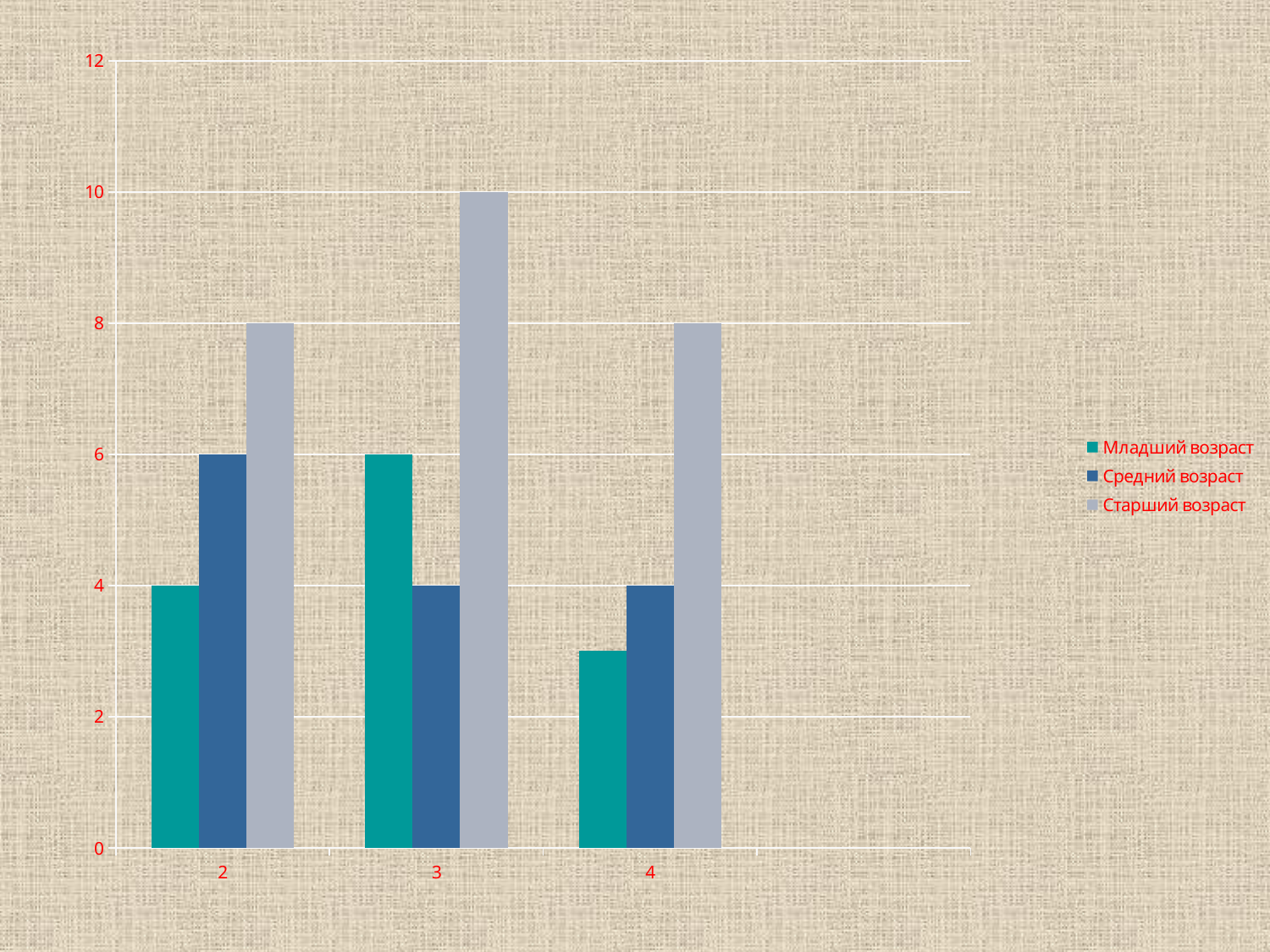
What is the difference between the Старший возраст values in category 3 and category 2? 2 How many categories are shown on the x axis? 3 What is the value for Старший возраст in category 3? 10 Is the value for Младший возраст in category 4 greater or less than 4? less How many series does the legend list? 3 Which series is shown in light gray in the legend? Старший возраст What is the value for Младший возраст in category 2? 4 In which category is the value for Старший возраст highest? 3 Does the value for Средний возраст rise or fall from category 2 to category 3? fall In category 2, which is larger: Младший возраст or Средний возраст? Средний возраст What is the value for Средний возраст in category 2? 6 What kind of chart is shown on the slide? bar chart